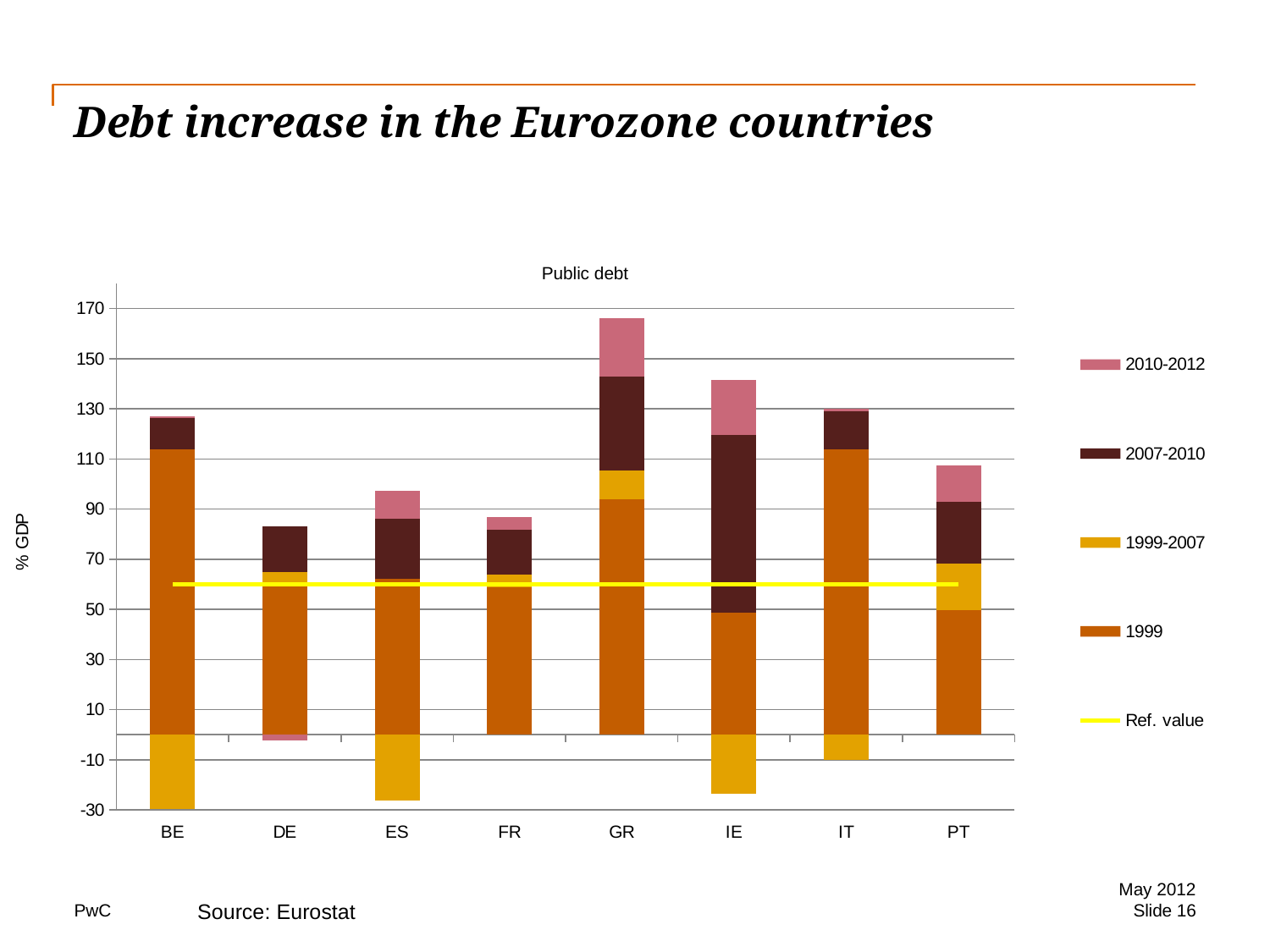
Is the top of the stacked bar for DE greater or less than 90? less What kind of chart is shown on the slide? Stacked bar chart How many entries does the legend of the Public debt chart list? 5 Which country has the largest 2007-2010 segment in the chart? IE Which country has the highest total public debt bar in the chart? GR Which country has a higher total public debt bar, BE or PT? BE What is the label on the y axis of the chart? % GDP Is the top of the stacked bar for GR greater or less than 150? greater Which country has a higher total public debt bar, GR or IE? GR Is the 1999 value for BE greater or less than 110? greater How many countries are shown on the x axis of the Public debt chart? 8